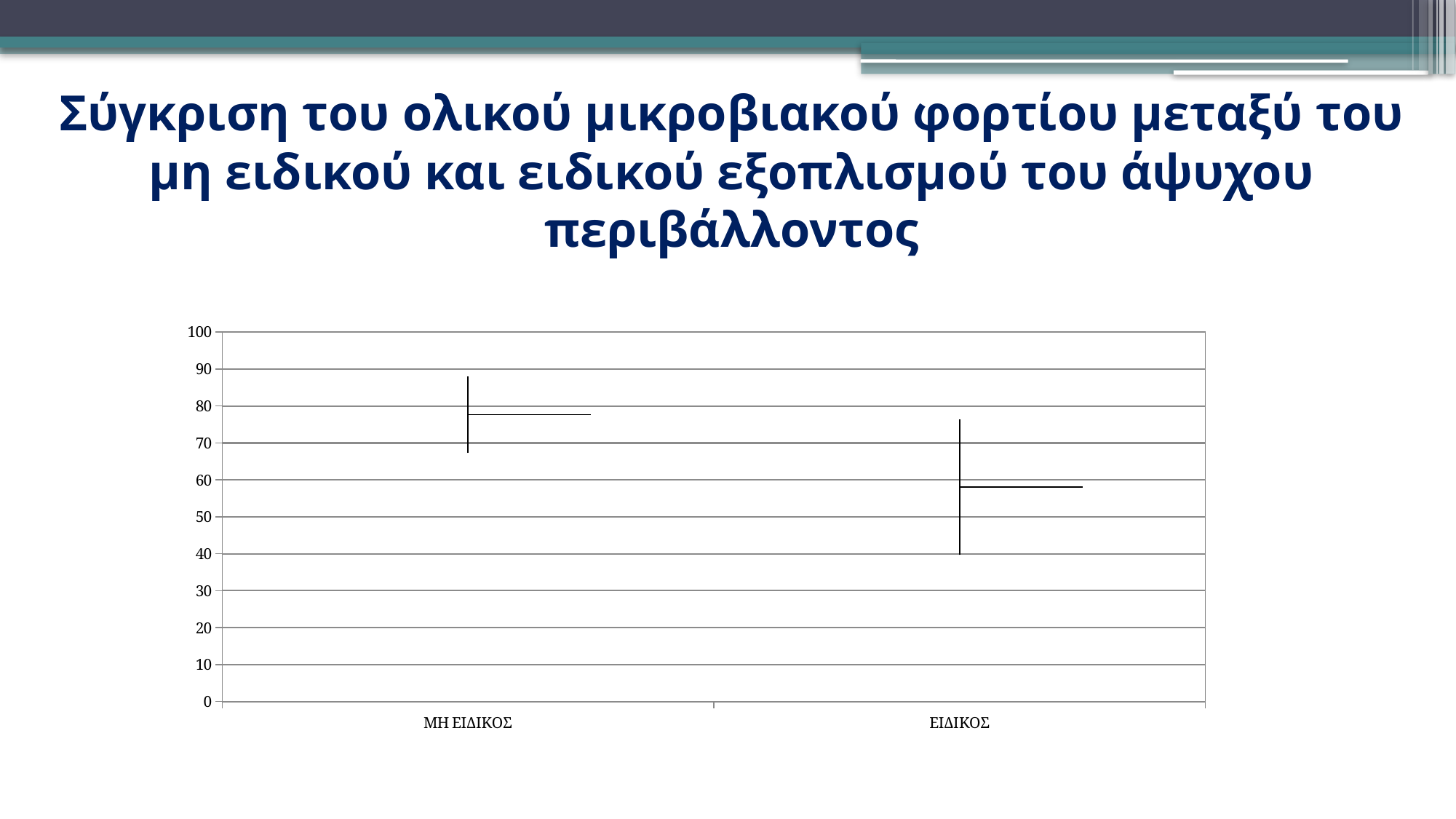
Which category has the higher marked value, ΜΗ ΕΙΔΙΚΟΣ or ΕΙΔΙΚΟΣ? ΜΗ ΕΙΔΙΚΟΣ Is the marked value for ΜΗ ΕΙΔΙΚΟΣ greater or less than 90? less Which category has the lower marked value? ΕΙΔΙΚΟΣ Do the marked values rise or fall from ΜΗ ΕΙΔΙΚΟΣ to ΕΙΔΙΚΟΣ? fall Is the top of the vertical range line for ΕΙΔΙΚΟΣ greater or less than 80? less What is the maximum value shown on the y axis of the chart? 100 How many categories are shown on the x axis of the chart? 2 Is the marked value for ΕΙΔΙΚΟΣ greater or less than 70? less What is the label of the first category on the x axis? ΜΗ ΕΙΔΙΚΟΣ